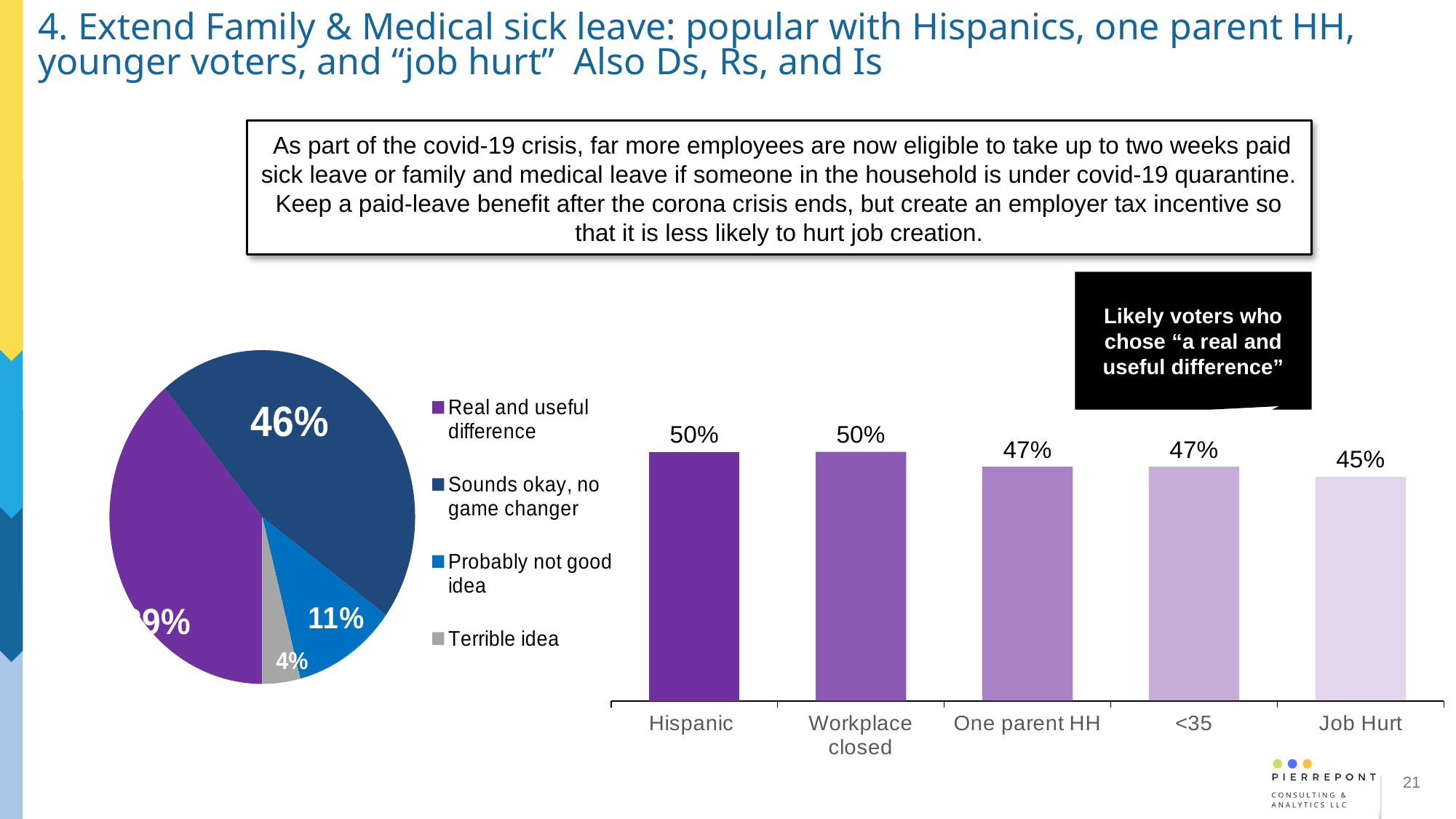
How many categories are shown in the bar chart on the right? 5 In the bar chart on the right, which is larger: the value for One parent HH or the value for Job Hurt? One parent HH How many entries does the legend of the pie chart on the left list? 4 In the pie chart on the left, what share chose "Probably not good idea"? 11% In the bar chart on the right, what is the value for Job Hurt? 45% In the bar chart on the right, do the values rise or fall from left to right? Fall In the bar chart on the right, what percentage of Hispanic likely voters chose "a real and useful difference"? 50% What kind of chart is the chart on the right of the slide? Bar chart In the bar chart on the right, what is the difference between the Hispanic value and the Job Hurt value? 5% In the pie chart on the left, what share chose "Terrible idea"? 4% In the pie chart on the left, what share chose "Sounds okay, no game changer"? 46% In the bar chart on the right, which category has the lowest value? Job Hurt